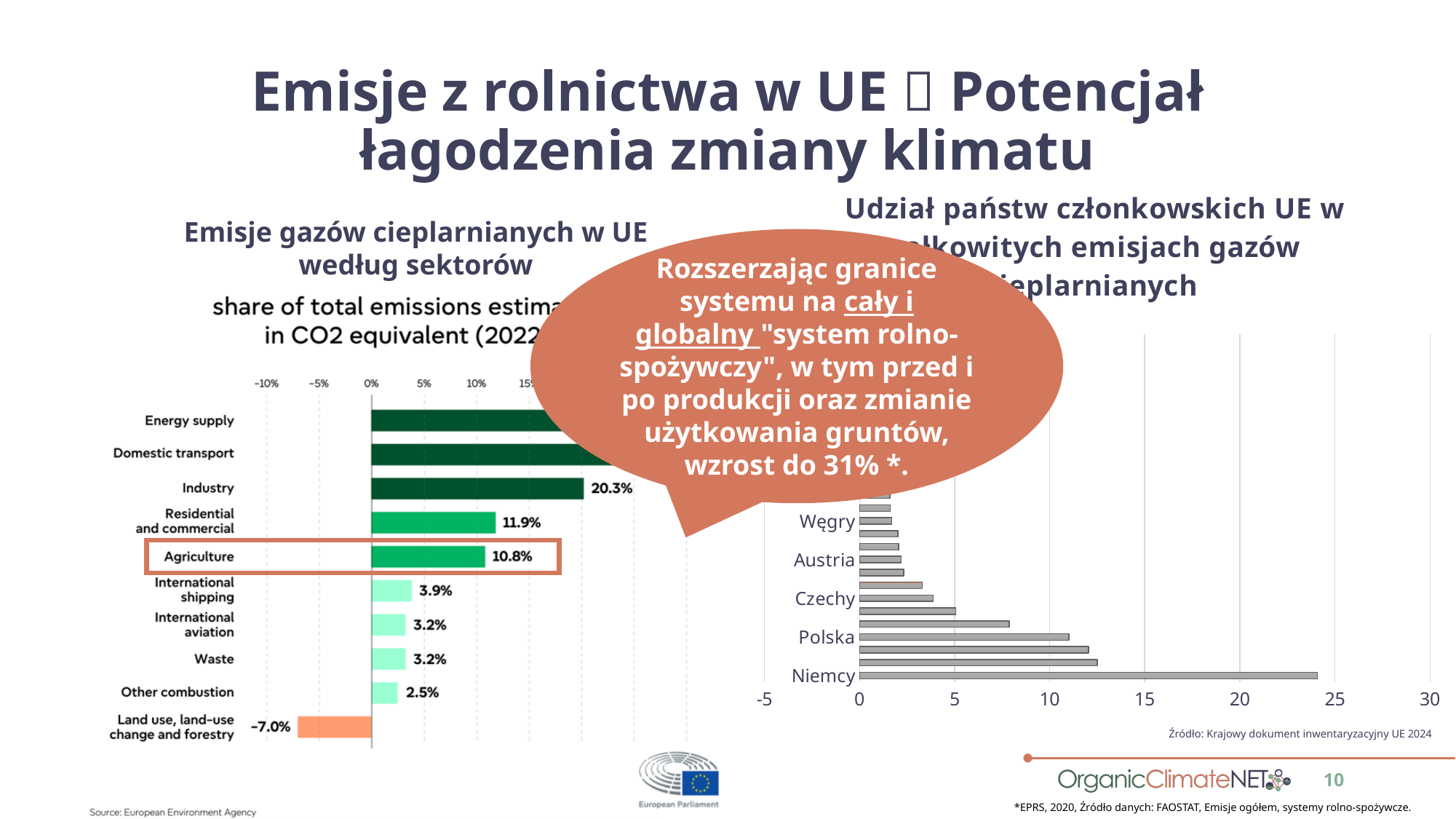
In the right chart (Udział państw członkowskich UE w całkowitych emisjach gazów cieplarnianych), is the value for Niemcy greater or less than 20? greater In the left chart (Emisje gazów cieplarnianych w UE według sektorów), how many sectors are shown? 10 What kind of chart is the left chart (Emisje gazów cieplarnianych w UE według sektorów)? Bar chart In the left chart (Emisje gazów cieplarnianych w UE według sektorów), which sector has the lowest value? Land use, land-use change and forestry In the left chart (Emisje gazów cieplarnianych w UE według sektorów), what is the value for Agriculture? 10.8% In the left chart (Emisje gazów cieplarnianych w UE według sektorów), which sector is highlighted with an orange box? Agriculture In the right chart (Udział państw członkowskich UE w całkowitych emisjach gazów cieplarnianych), which is larger: Niemcy or Polska? Niemcy In the left chart (Emisje gazów cieplarnianych w UE według sektorów), what is the difference between Industry and Agriculture? 9.5 percentage points In the left chart (Emisje gazów cieplarnianych w UE według sektorów), what is the value for Industry? 20.3% In the left chart (Emisje gazów cieplarnianych w UE według sektorów), what is the value for Land use, land-use change and forestry? -7.0% In the left chart (Emisje gazów cieplarnianych w UE według sektorów), which is larger: Residential and commercial or Agriculture? Residential and commercial In the right chart (Udział państw członkowskich UE w całkowitych emisjach gazów cieplarnianych), is the value for Austria greater or less than 5? less